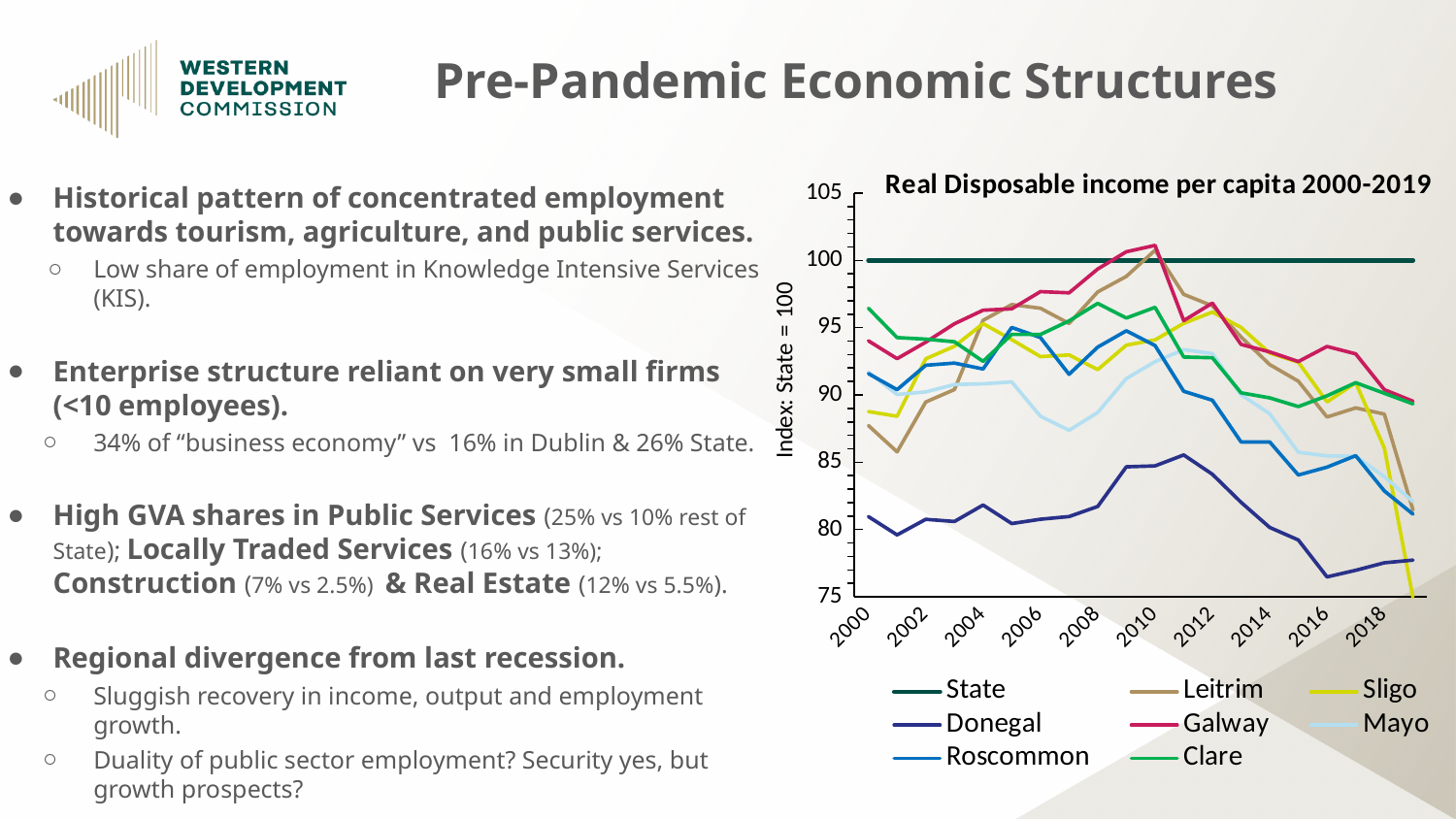
What is the value of the State series across the years shown? 100 How many series does the chart legend list? 8 What is the title of the chart? Real Disposable income per capita 2000-2019 Is the value for Galway in 2010 greater or less than 100? greater Is the value for Donegal in 2000 greater or less than 85? less What kind of chart is shown on the slide? line chart Which county series has the highest value in 2010? Galway Does the Galway series rise or fall between 2010 and 2019? fall Is the value for Mayo in 2008 greater or less than 90? less What is the label on the vertical axis of the chart? Index: State = 100 Which county series has the lowest value in 2000? Donegal In 2010, which is larger: the value for Galway or the value for Donegal? Galway